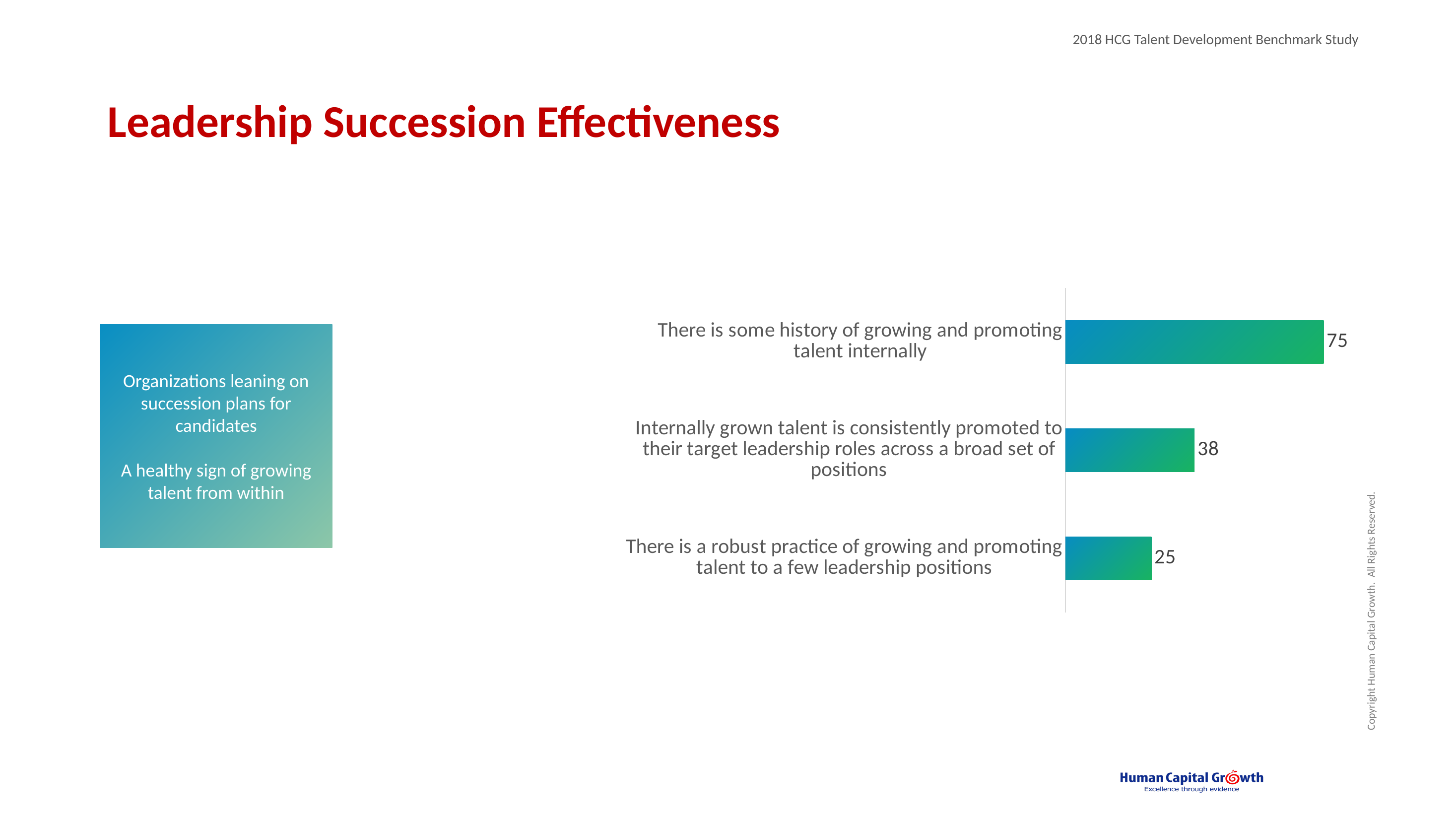
What is the value for "There is some history of growing and promoting talent internally"? 75 Which category has the highest value? There is some history of growing and promoting talent internally What is the difference between the value for "There is some history of growing and promoting talent internally" and the value for "Internally grown talent is consistently promoted to their target leadership roles across a broad set of positions"? 37 What is the title of the slide containing the chart? Leadership Succession Effectiveness What kind of chart is shown on the slide? Bar chart How many categories does the chart show? 3 What is the value for "Internally grown talent is consistently promoted to their target leadership roles across a broad set of positions"? 38 What is the difference between the value for "Internally grown talent is consistently promoted to their target leadership roles across a broad set of positions" and the value for "There is a robust practice of growing and promoting talent to a few leadership positions"? 13 What is the value for "There is a robust practice of growing and promoting talent to a few leadership positions"? 25 Which is larger: the value for "Internally grown talent is consistently promoted to their target leadership roles across a broad set of positions" or the value for "There is a robust practice of growing and promoting talent to a few leadership positions"? Internally grown talent is consistently promoted to their target leadership roles across a broad set of positions Are the bars in the chart oriented horizontally or vertically? Horizontally Which category has the lowest value? There is a robust practice of growing and promoting talent to a few leadership positions